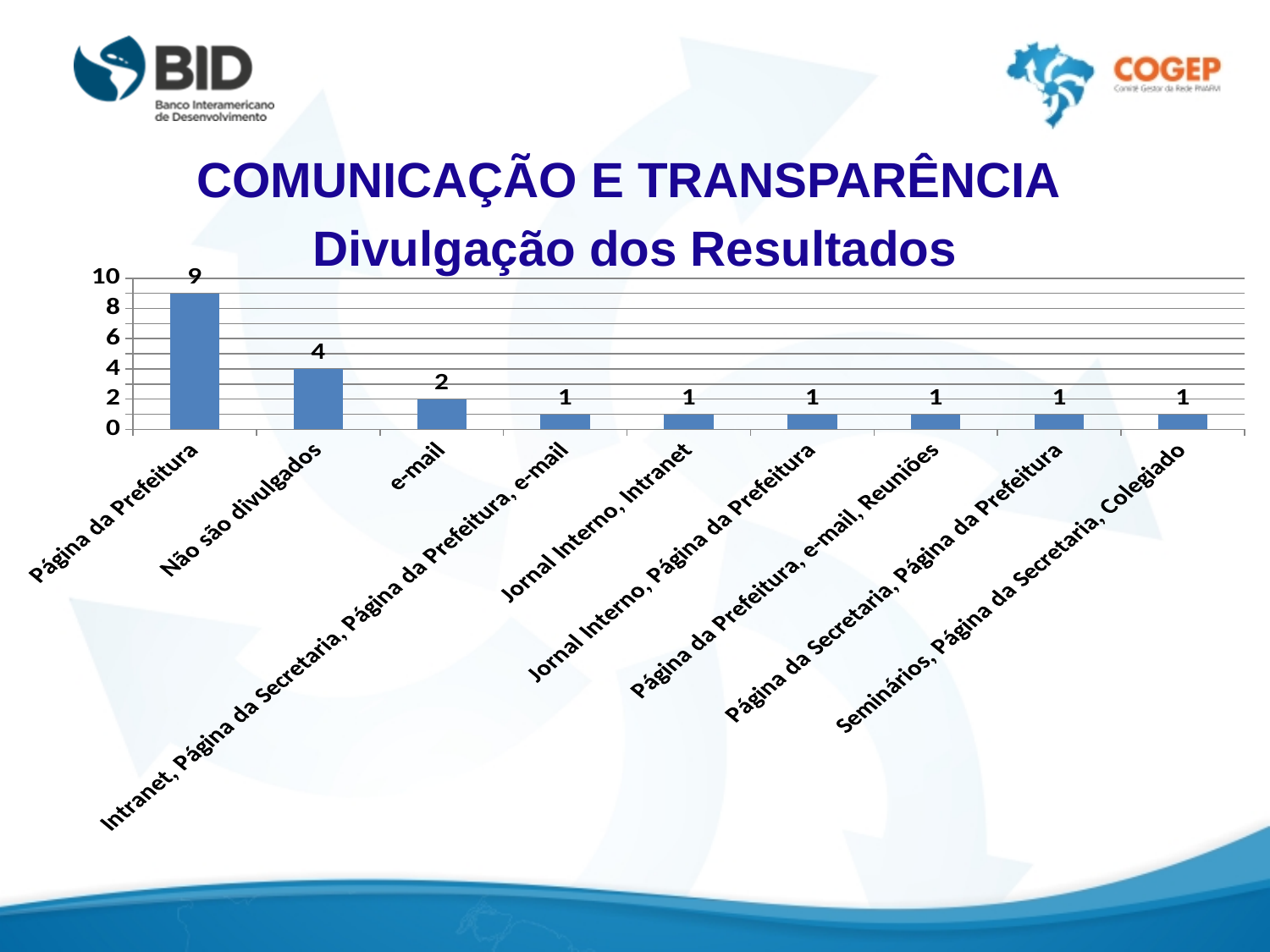
Which is larger, the value for "e-mail" or the value for "Seminários, Página da Secretaria, Colegiado"? e-mail What is the difference between the values for "Não são divulgados" and "e-mail"? 2 What is the value for "Página da Prefeitura"? 9 What is the difference between the values for "Página da Prefeitura" and "Não são divulgados"? 5 How many categories have a value of 1? 6 What kind of chart is shown on the slide? bar chart Is the value for "Página da Prefeitura" greater or less than 8? greater What is the value for "Jornal Interno, Intranet"? 1 What is the value for "e-mail"? 2 How many categories are shown on the x axis? 9 Which category has the highest value? Página da Prefeitura What is the value for "Não são divulgados"? 4